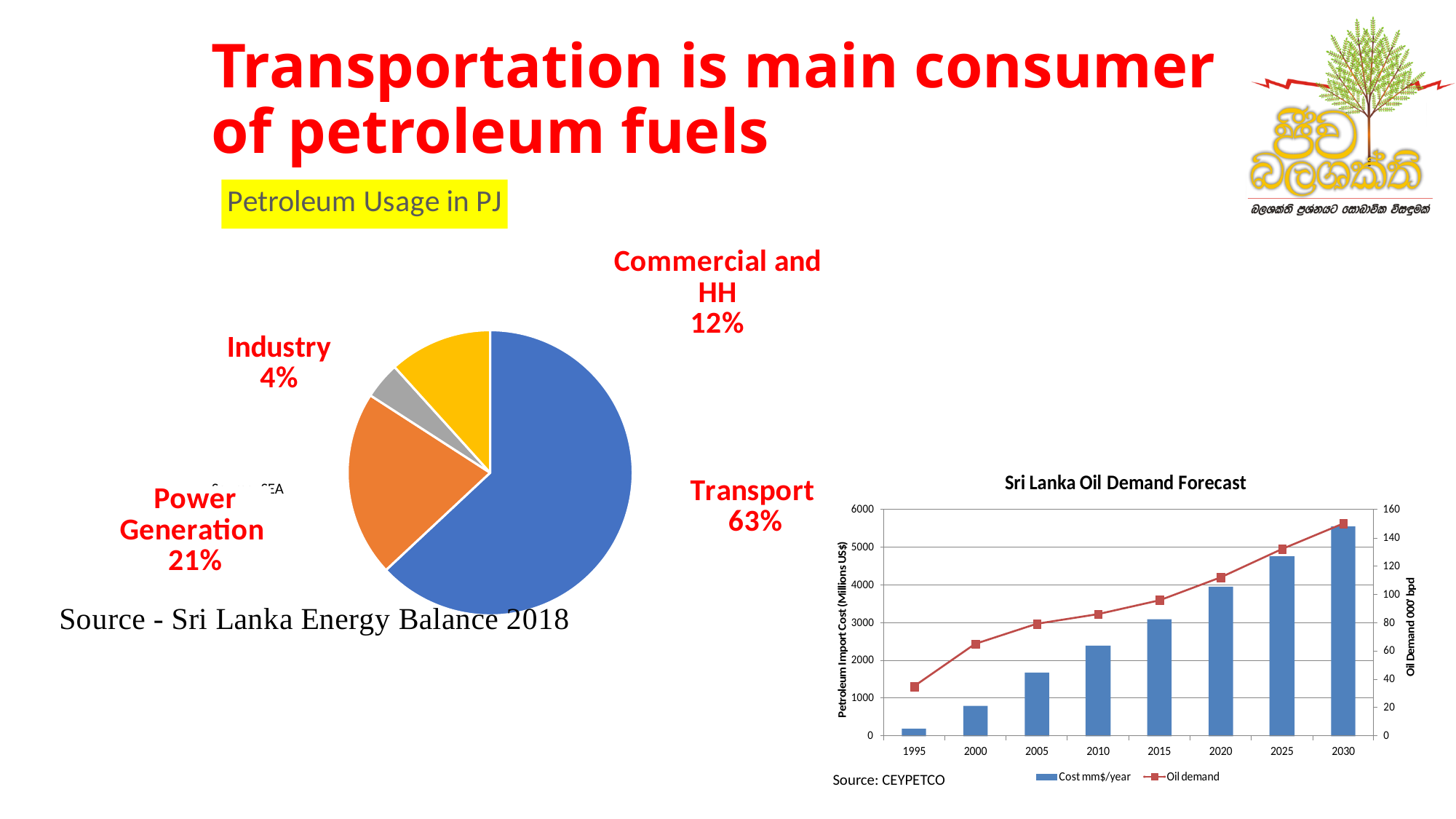
In the Petroleum Usage in PJ pie chart, what share does Industry have? 4% In the Petroleum Usage in PJ pie chart, what share does Transport have? 63% What kind of chart is the Sri Lanka Oil Demand Forecast chart? Combined bar and line chart In the Sri Lanka Oil Demand Forecast chart, is the Cost mm$/year value for 2030 greater or less than 5000? greater In the Sri Lanka Oil Demand Forecast chart, is the Cost mm$/year value for 1995 greater or less than 1000? less In the Petroleum Usage in PJ pie chart, which category has the smallest share? Industry In the Sri Lanka Oil Demand Forecast chart, how many series does the legend list? 2 In the Sri Lanka Oil Demand Forecast chart, does the Oil demand line rise or fall from 1995 to 2030? rise In the Petroleum Usage in PJ pie chart, which category has the largest share? Transport In the Petroleum Usage in PJ pie chart, what share does Power Generation have? 21% In the Petroleum Usage in PJ pie chart, what is the difference in percentage points between Transport and Power Generation? 42 In the Petroleum Usage in PJ pie chart, how many slices are there? 4